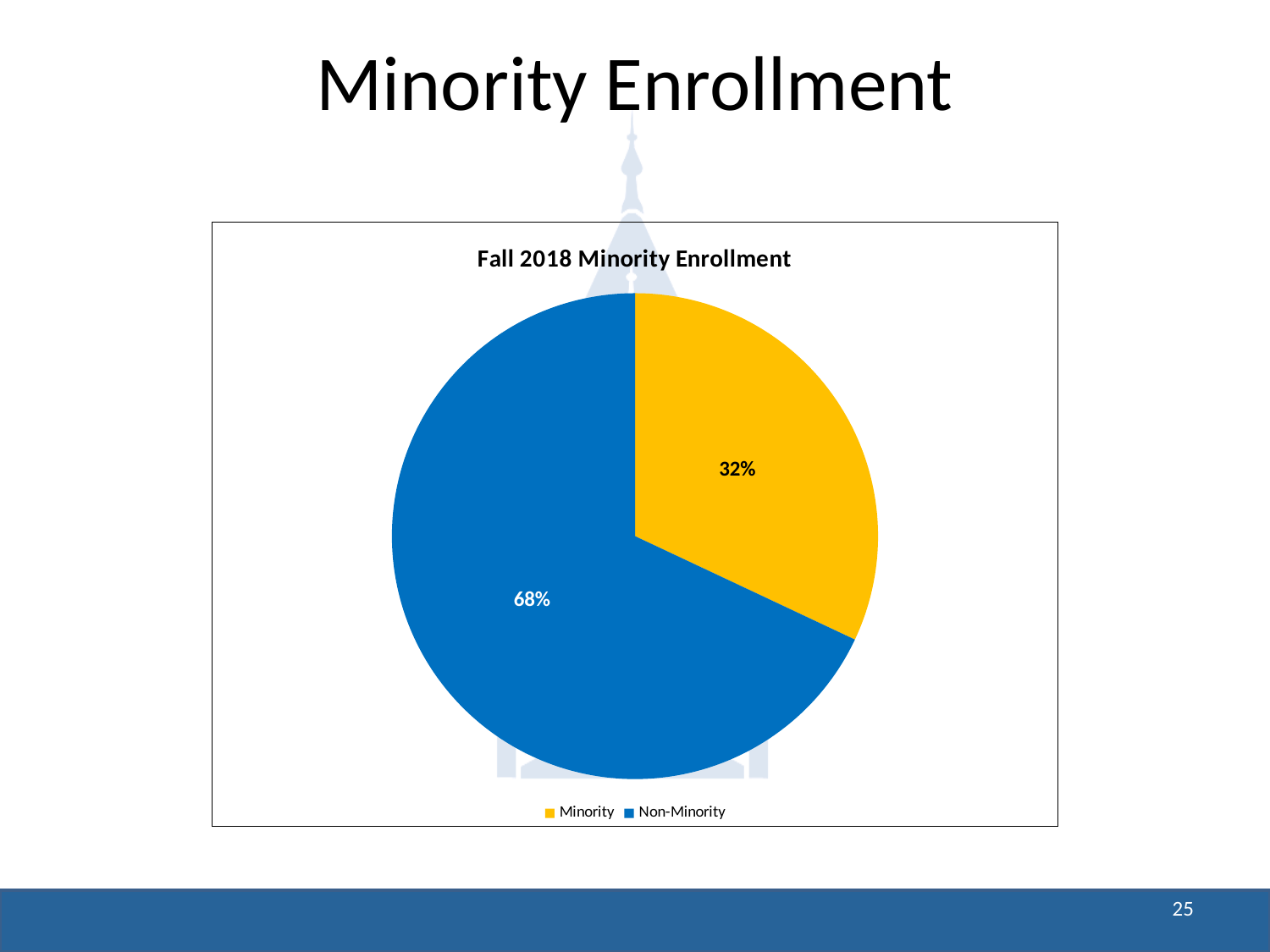
How many entries does the legend list? 2 Which slice of the pie is the smallest? Minority What type of chart is shown on the slide? pie chart How many slices does the pie chart have? 2 What colour is the Minority slice? yellow What percentage of enrollment is Non-Minority? 68% What share of the pie does the Minority slice represent? 32% What percentage of enrollment is Minority? 32% Which is larger, the Minority slice or the Non-Minority slice? Non-Minority What is the title of the chart? Fall 2018 Minority Enrollment Which slice of the pie is the largest? Non-Minority What is the difference in percentage points between the Non-Minority and Minority slices? 36